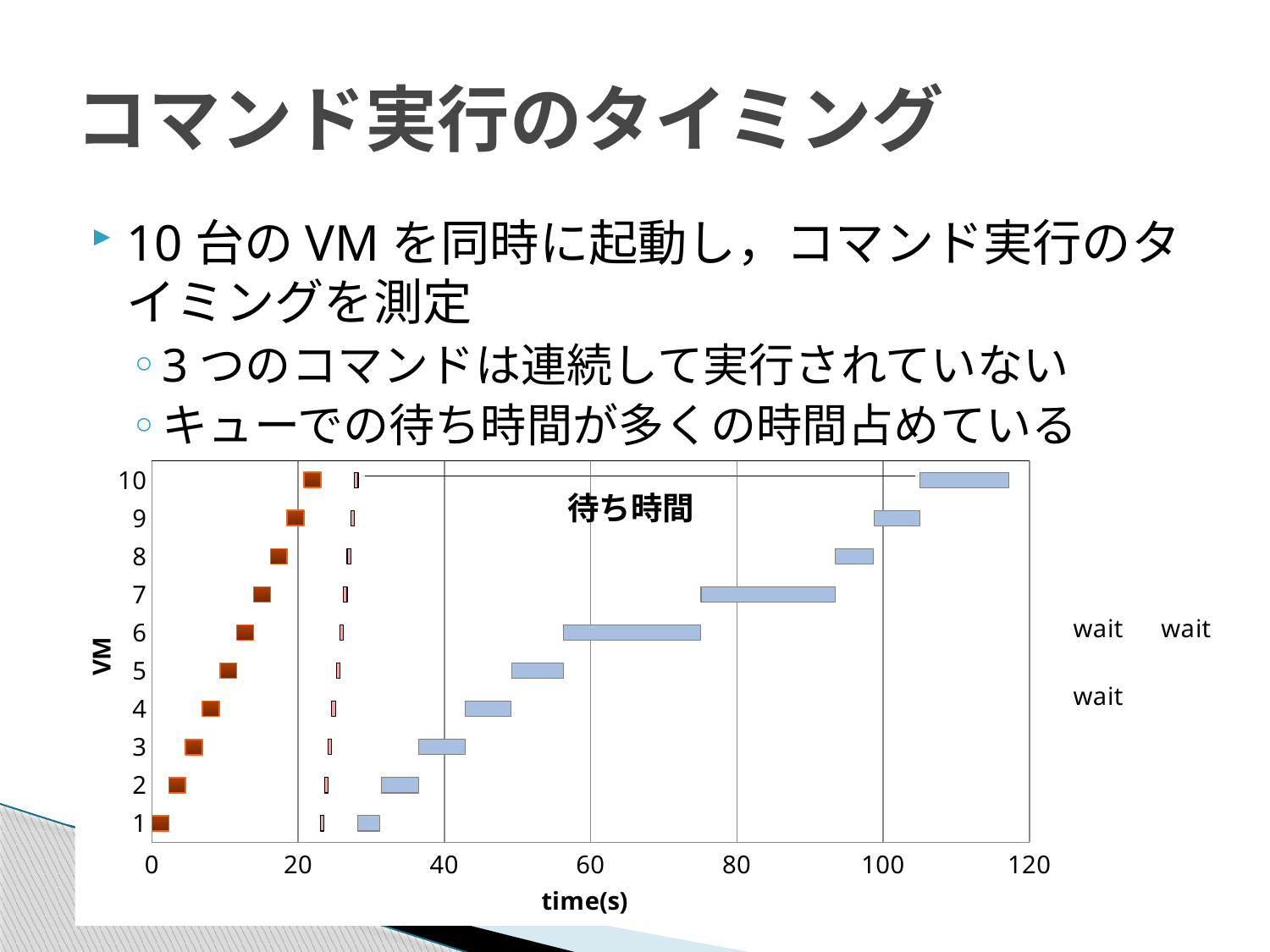
What is the label of the vertical axis of the chart? VM Does the blue bar for VM 9 start before or after the blue bar for VM 8? after How many VMs are listed on the vertical axis of the chart? 10 As the VM number increases from 1 to 10, does the start time of the blue bar rise or fall? rise What kind of chart is shown on the slide? bar chart What is the label of the horizontal axis of the chart? time(s) Which VM has the blue bar that ends latest on the time axis? 10 Is the time of the orange marker for VM 10 greater or less than 20? greater Is the start time of the blue bar for VM 10 greater or less than 100? greater Which VM has the blue bar that starts earliest on the time axis? 1 Is the end time of the blue bar for VM 1 greater or less than 40? less